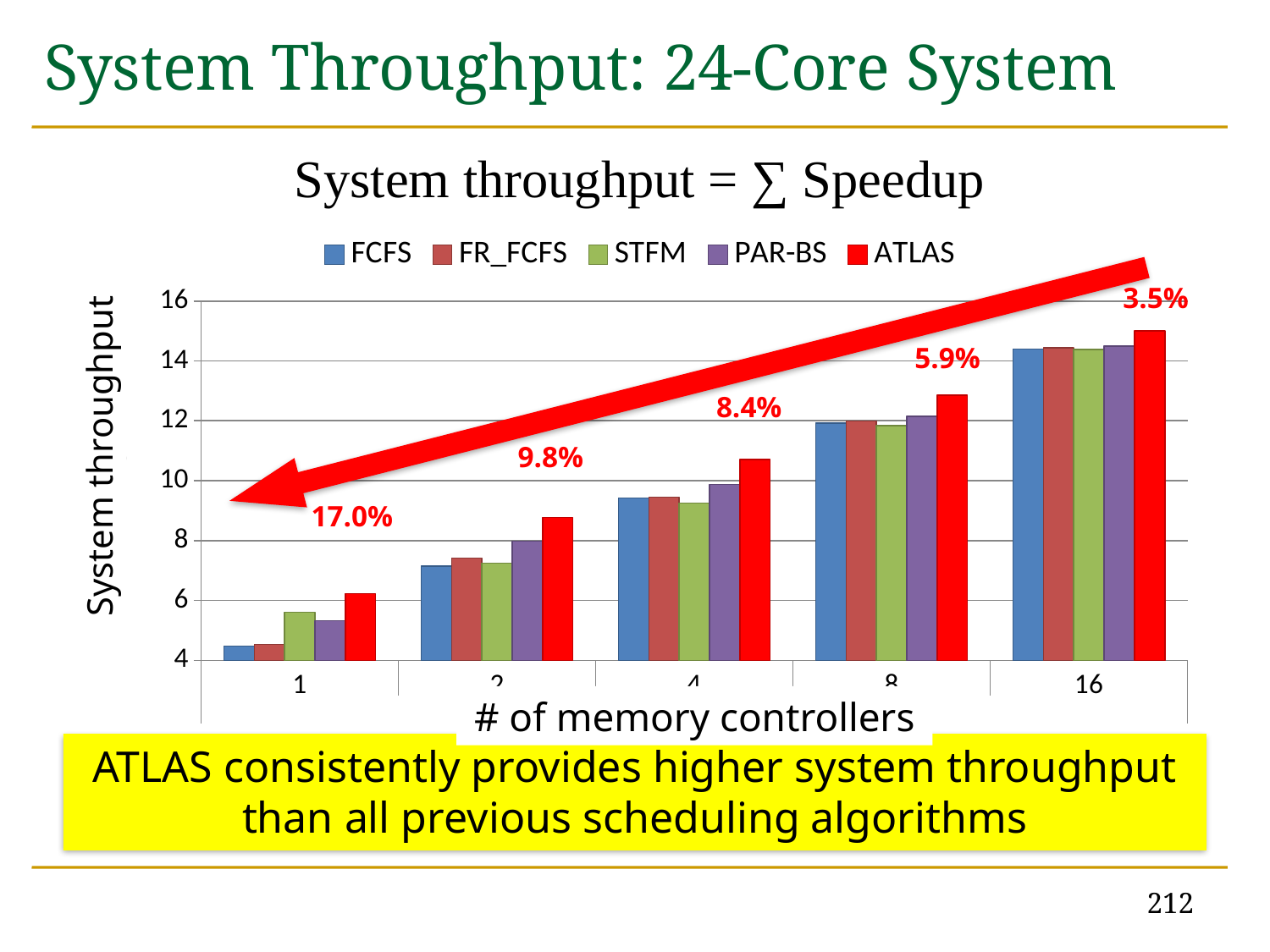
Is the value for FCFS in the second group from the left greater or less than 8? less What type of chart is shown on the slide? bar chart What percentage is annotated above the group for 1 memory controller? 17.0% Which is larger at 16 memory controllers: the FCFS bar or the ATLAS bar? ATLAS Is the value for FCFS at 1 memory controller greater or less than 6? less How many series does the legend list? 5 Is the value for ATLAS at 16 memory controllers greater or less than 14? greater Which series has the lowest system throughput at 1 memory controller? FCFS What percentage is annotated above the group for 16 memory controllers? 3.5% Does system throughput rise or fall as the number of memory controllers increases? rise How many groups of bars (memory controller counts) are plotted along the x axis? 5 Which series has the highest system throughput at 16 memory controllers? ATLAS